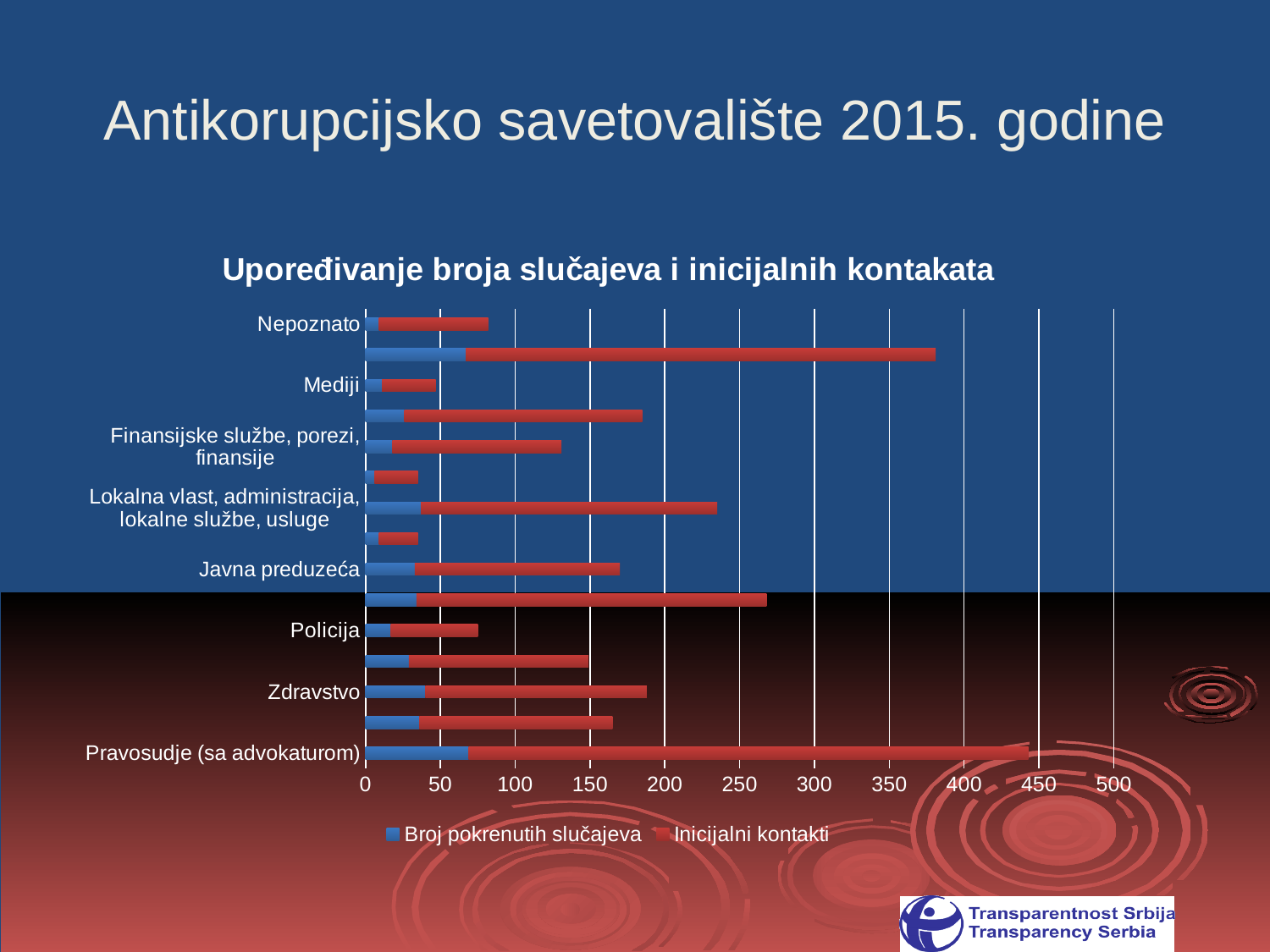
Is the total bar length for Pravosudje (sa advokaturom) greater or less than 400? greater Is the total bar length for Lokalna vlast, administracija, lokalne službe, usluge greater or less than 200? greater How many series does the chart legend list? 2 Is the total bar length for Nepoznato greater or less than 100? less Which has the longer total bar, Pravosudje (sa advokaturom) or Zdravstvo? Pravosudje (sa advokaturom) What is the title of the chart? Upoređivanje broja slučajeva i inicijalnih kontakata Which category has the longest bar in the chart? Pravosudje (sa advokaturom) Which has the longer total bar, Nepoznato or Mediji? Nepoznato Which colour represents the series "Inicijalni kontakti" in the chart? Red What kind of chart is shown on the slide? Bar chart